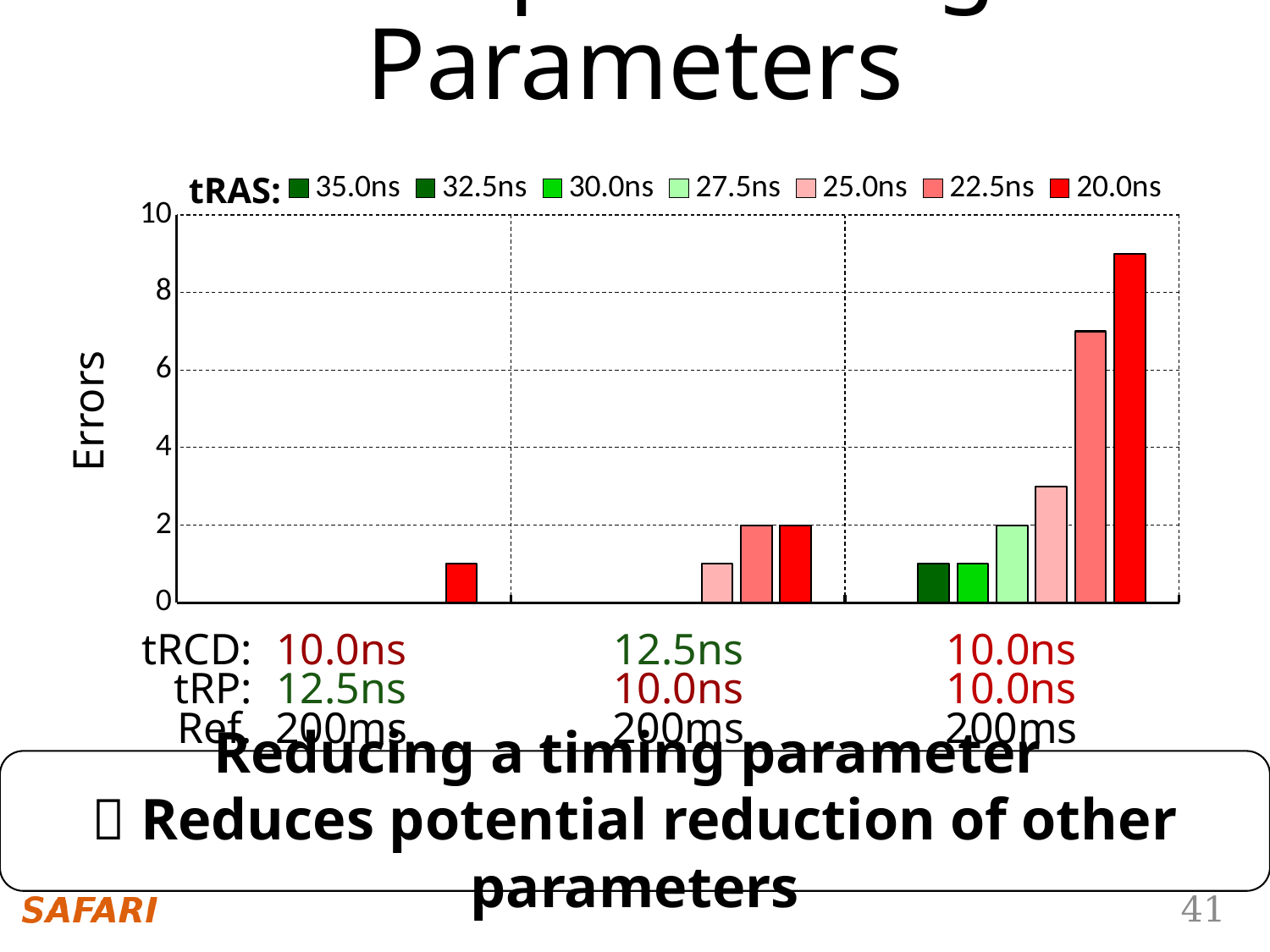
Which group of bars contains the tallest bar on the chart? tRCD 10.0ns, tRP 10.0ns Is the number of errors for tRAS 20.0ns in the group with tRCD 10.0ns and tRP 10.0ns greater or less than 8? greater In the group with tRCD 10.0ns and tRP 10.0ns, which has more errors: tRAS 22.5ns or tRAS 27.5ns? 22.5ns What kind of chart is shown on the slide? bar chart Is the number of errors for tRAS 22.5ns in the group with tRCD 10.0ns and tRP 10.0ns greater or less than 6? greater In the group with tRCD 12.5ns and tRP 10.0ns, how many errors are shown for tRAS 22.5ns? 2 How many groups of bars (tRCD/tRP/Ref settings) are shown along the x axis? 3 How many tRAS series does the legend list? 7 What is the label on the y axis of the chart? Errors In the group with tRCD 10.0ns and tRP 10.0ns, which tRAS value has the highest number of errors? 20.0ns Is the number of errors for tRAS 20.0ns in the group with tRCD 10.0ns and tRP 12.5ns greater or less than 2? less